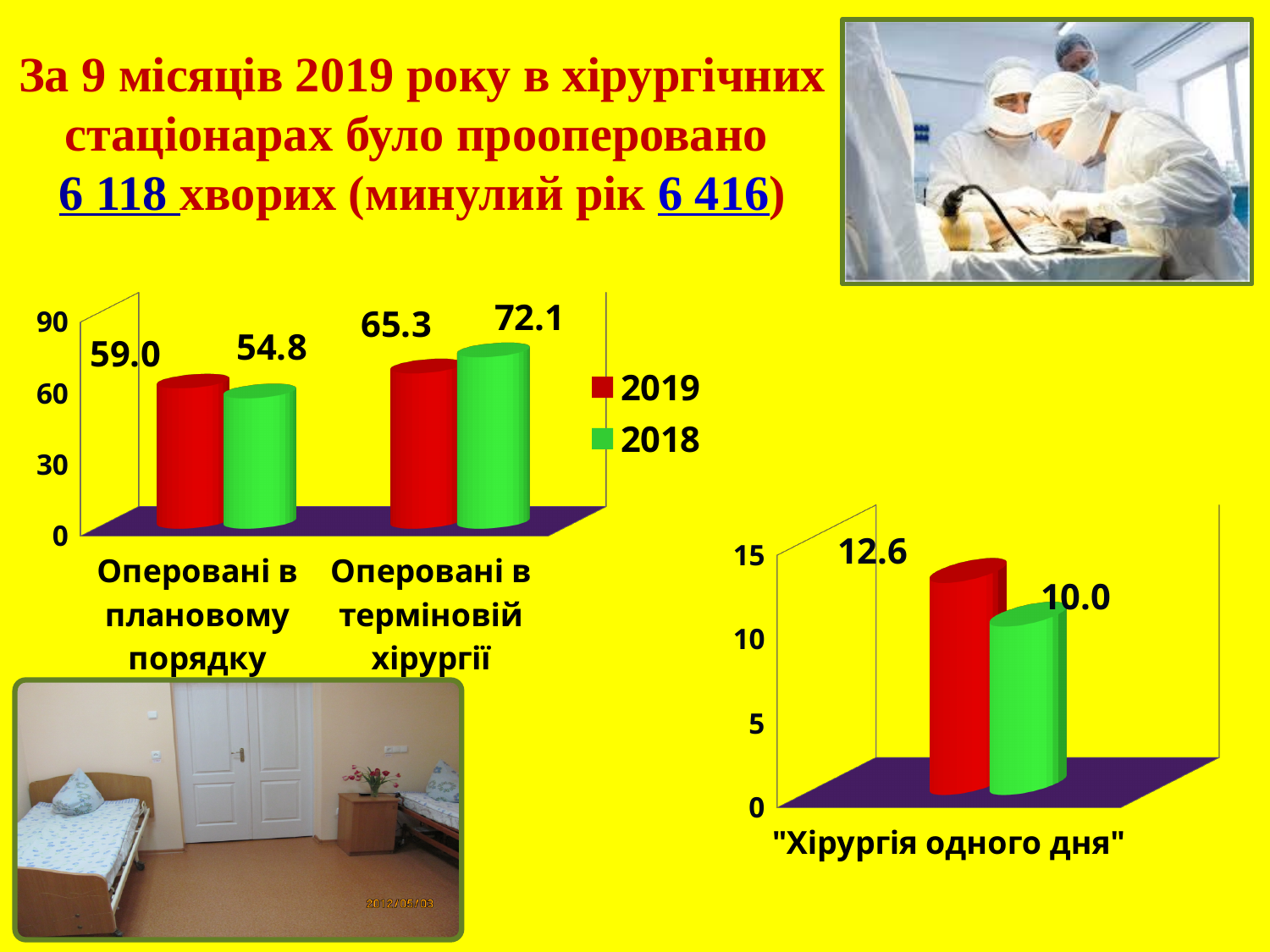
In the left chart, what is the 2018 value for "Оперовані в терміновій хірургії"? 72.1 In the left chart, which category has the highest 2018 value? Оперовані в терміновій хірургії How many categories are shown on the x axis of the left chart? 2 In the chart titled "Хірургія одного дня", what is the value of the red bar? 12.6 In the left chart, what is the 2019 value for "Оперовані в терміновій хірургії"? 65.3 In the left chart, what is the 2019 value for "Оперовані в плановому порядку"? 59.0 In the chart titled "Хірургія одного дня", what is the difference between the red bar and the green bar? 2.6 In the left chart, for "Оперовані в плановому порядку", which year has the larger value, 2019 or 2018? 2019 What kind of chart is the chart titled "Хірургія одного дня"? Bar chart How many series does the legend of the left chart list? 2 In the left chart, what is the 2018 value for "Оперовані в плановому порядку"? 54.8 In the left chart, what is the difference between the 2018 and 2019 values for "Оперовані в терміновій хірургії"? 6.8